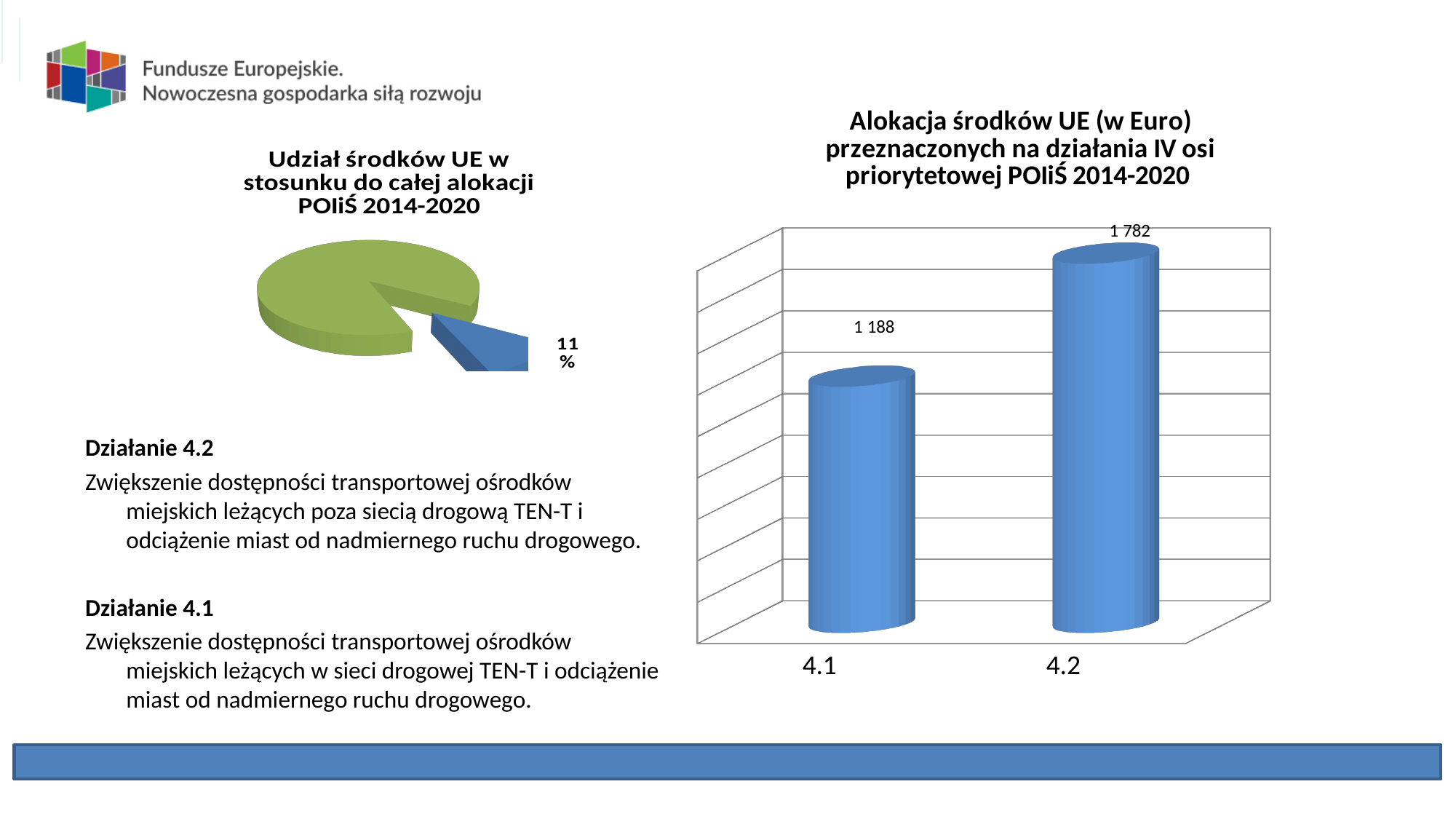
In the bar chart on the right, what is the value for 4.1? 1 188 What kind of chart is the chart on the right of the slide? Bar chart In the bar chart on the right, what is the difference between the values for 4.2 and 4.1? 594 In the bar chart on the right, do the values rise or fall from 4.1 to 4.2? Rise In the bar chart on the right, which category has the highest value? 4.2 How many categories are shown in the bar chart on the right? 2 In the pie chart on the left, what share does the blue slice represent? 11% In the bar chart on the right, what is the value for 4.2? 1 782 In the bar chart on the right, which category has the lowest value? 4.1 What kind of chart is the chart on the left of the slide? Pie chart What is the title of the bar chart on the right? Alokacja środków UE (w Euro) przeznaczonych na działania IV osi priorytetowej POIiŚ 2014-2020 In the bar chart on the right, which is larger, the value for 4.1 or the value for 4.2? 4.2